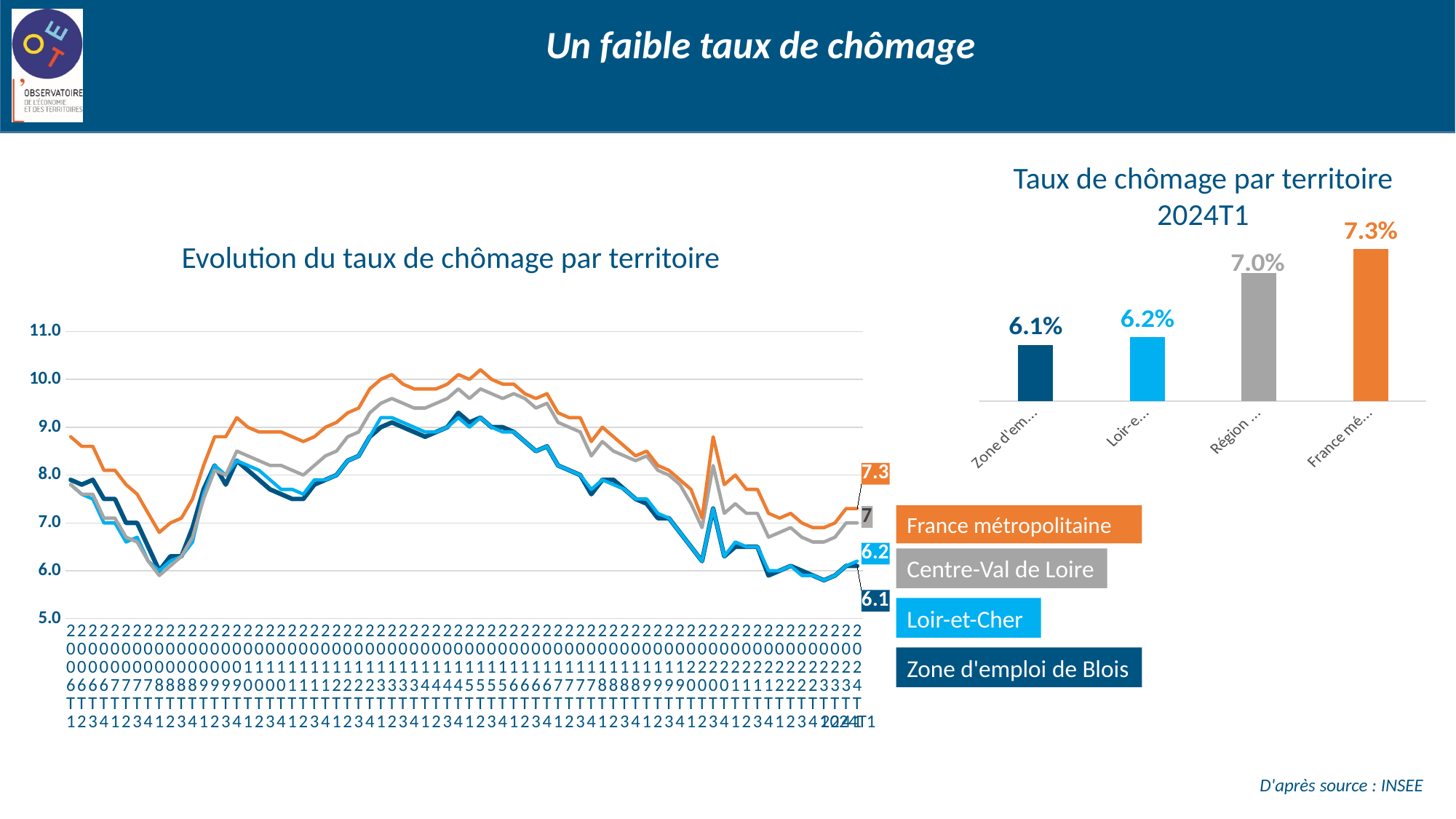
What kind of chart is 'Evolution du taux de chômage par territoire'? Line chart In the bar chart 'Taux de chômage par territoire 2024T1', what is the value for France métropolitaine? 7.3% How many series are plotted in the chart 'Evolution du taux de chômage par territoire'? 4 In the bar chart 'Taux de chômage par territoire 2024T1', which territory has the lowest unemployment rate? Zone d'emploi de Blois In the bar chart 'Taux de chômage par territoire 2024T1', what is the value for Loir-et-Cher? 6.2% In the bar chart 'Taux de chômage par territoire 2024T1', what is the difference between France métropolitaine and Zone d'emploi de Blois? 1.2 percentage points How many bars are shown in the bar chart 'Taux de chômage par territoire 2024T1'? 4 What kind of chart is 'Taux de chômage par territoire 2024T1'? Bar chart In the chart 'Evolution du taux de chômage par territoire', what is the value for France métropolitaine at 2024T1? 7.3 In the chart 'Evolution du taux de chômage par territoire', what is the value for Centre-Val de Loire at 2024T1? 7 In the bar chart 'Taux de chômage par territoire 2024T1', which territory has the highest unemployment rate? France métropolitaine In the chart 'Evolution du taux de chômage par territoire', which is larger at 2024T1: Loir-et-Cher or Zone d'emploi de Blois? Loir-et-Cher